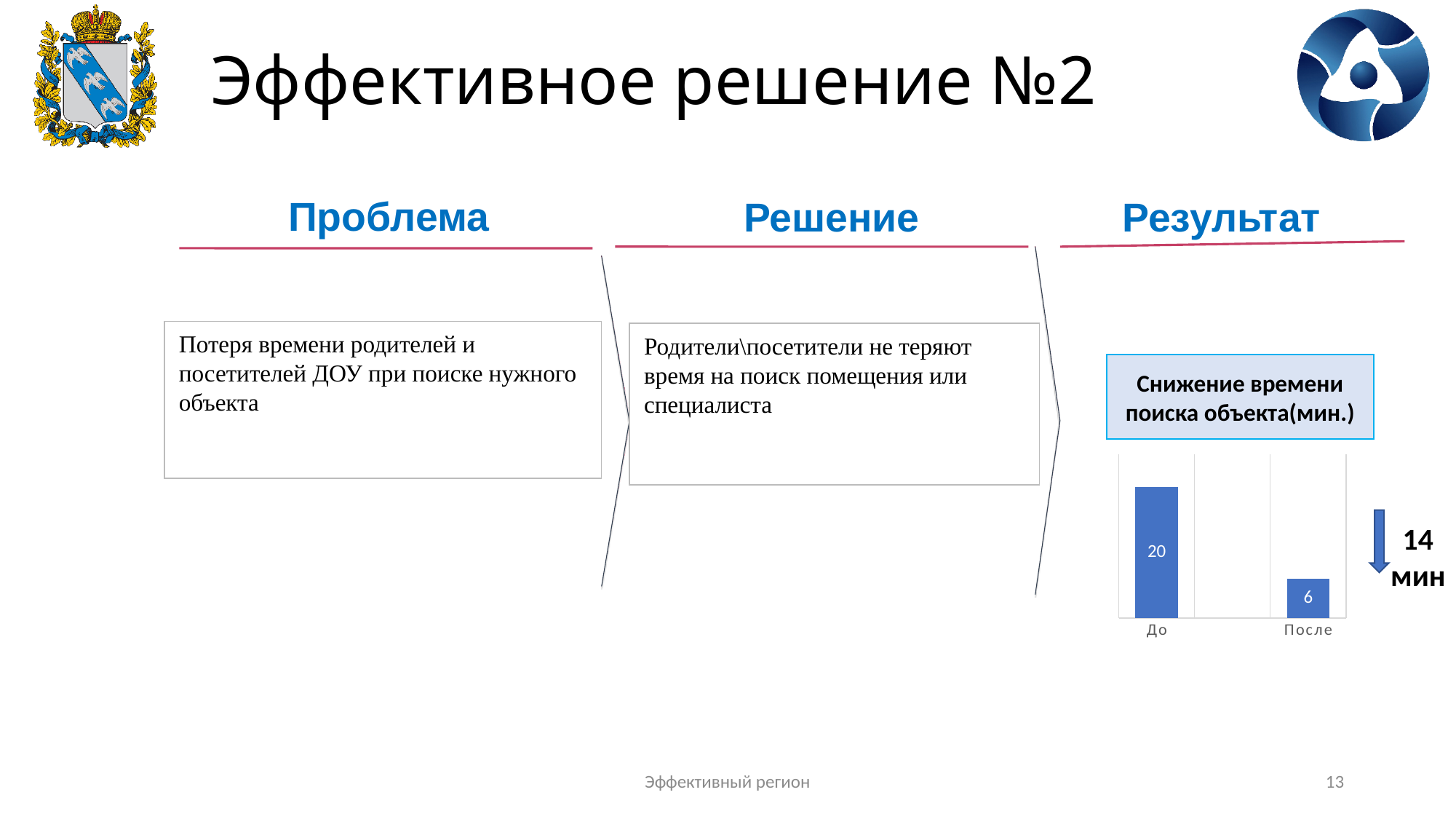
What is the value for "До" in the chart? 20 Which category has the lowest value in the chart? После What is the value for "После" in the chart? 6 Which category has the highest value in the chart? До Which is larger, the value for "До" or the value for "После"? До How many categories are shown in the chart? 2 What is the title of the chart? Снижение времени поиска объекта(мин.) What is the difference between the values for "До" and "После"? 14 What reduction in minutes is shown next to the arrow beside the chart? 14 мин Do the values rise or fall from "До" to "После"? fall What kind of chart is shown on the slide? bar chart